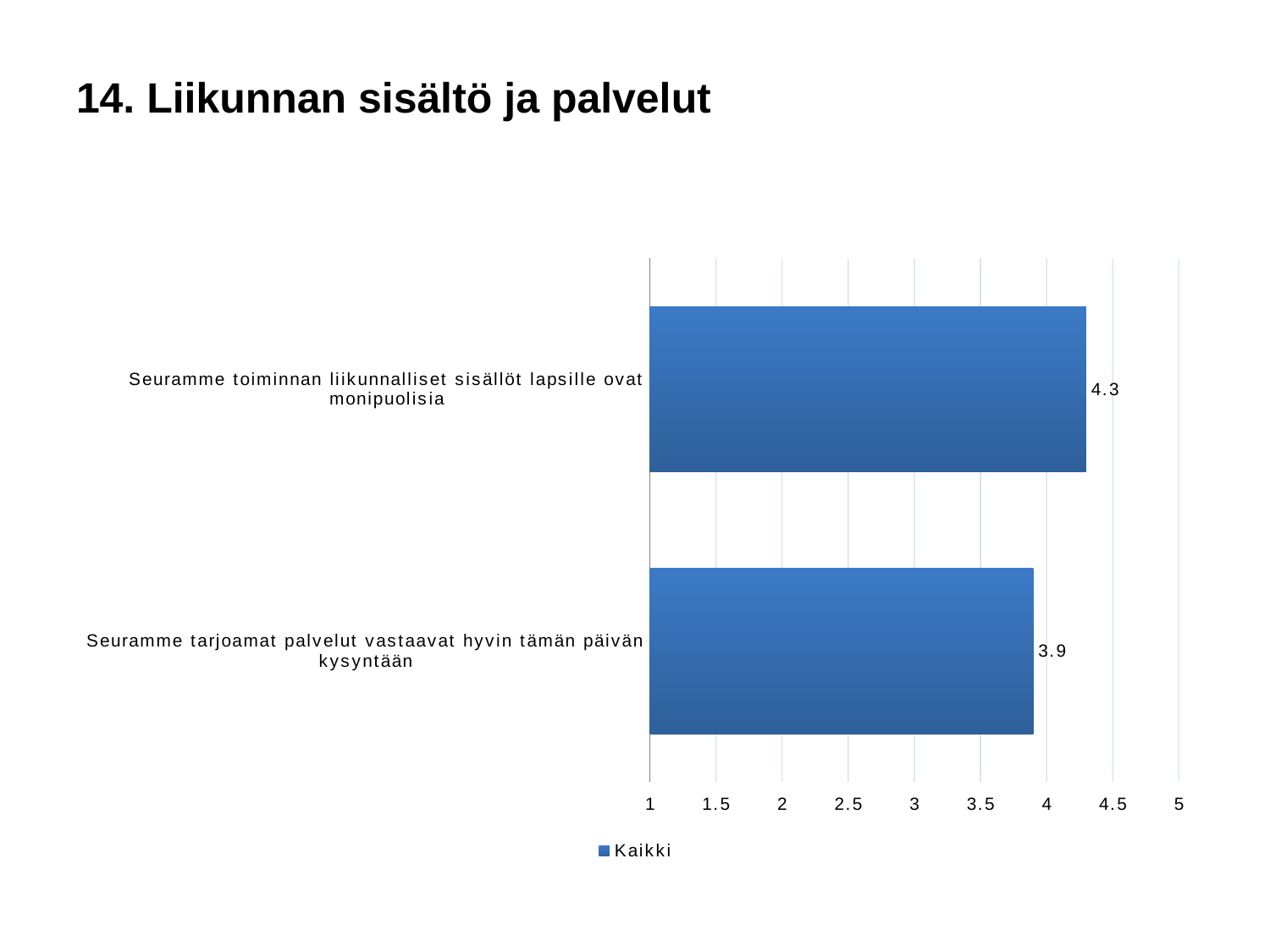
How many series does the legend list? 1 What is the value for "Seuramme toiminnan liikunnalliset sisällöt lapsille ovat monipuolisia"? 4.3 Is the value for "Seuramme toiminnan liikunnalliset sisällöt lapsille ovat monipuolisia" greater or less than 4? greater How many categories are shown in the chart? 2 What is the name of the series shown in the legend? Kaikki What is the value for "Seuramme tarjoamat palvelut vastaavat hyvin tämän päivän kysyntään"? 3.9 Is the value for "Seuramme tarjoamat palvelut vastaavat hyvin tämän päivän kysyntään" greater or less than 4? less Which category has the lowest value? Seuramme tarjoamat palvelut vastaavat hyvin tämän päivän kysyntään Which category has the highest value? Seuramme toiminnan liikunnalliset sisällöt lapsille ovat monipuolisia Which is larger: the value for "Seuramme toiminnan liikunnalliset sisällöt lapsille ovat monipuolisia" or for "Seuramme tarjoamat palvelut vastaavat hyvin tämän päivän kysyntään"? Seuramme toiminnan liikunnalliset sisällöt lapsille ovat monipuolisia What kind of chart is shown on the slide? bar chart What is the difference between the values for "Seuramme toiminnan liikunnalliset sisällöt lapsille ovat monipuolisia" and "Seuramme tarjoamat palvelut vastaavat hyvin tämän päivän kysyntään"? 0.4